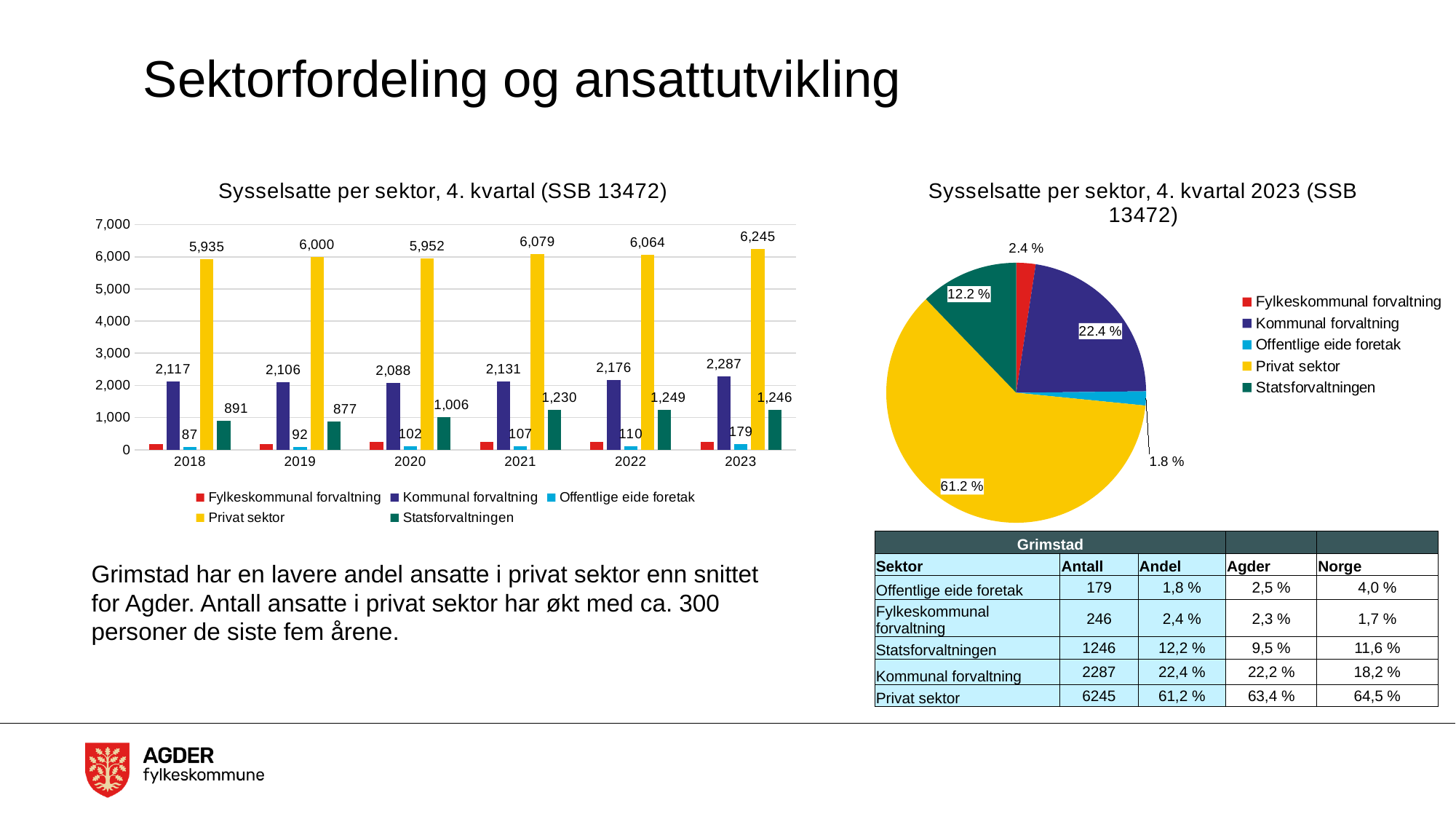
In the pie chart 'Sysselsatte per sektor, 4. kvartal 2023 (SSB 13472)', what share does Privat sektor have? 61.2 % In the bar chart 'Sysselsatte per sektor, 4. kvartal (SSB 13472)', how many years are shown on the x axis? 6 In the bar chart 'Sysselsatte per sektor, 4. kvartal (SSB 13472)', in which year is the Kommunal forvaltning value lowest? 2020 In the bar chart 'Sysselsatte per sektor, 4. kvartal (SSB 13472)', what is the difference between the Privat sektor values for 2023 and 2018? 310 In the pie chart 'Sysselsatte per sektor, 4. kvartal 2023 (SSB 13472)', which colour represents Statsforvaltningen? Dark green In the bar chart 'Sysselsatte per sektor, 4. kvartal (SSB 13472)', what is the value for Statsforvaltningen in 2021? 1,230 In the bar chart 'Sysselsatte per sektor, 4. kvartal (SSB 13472)', what is the value for Privat sektor in 2023? 6,245 In the bar chart 'Sysselsatte per sektor, 4. kvartal (SSB 13472)', what is the value for Offentlige eide foretak in 2019? 92 What kind of chart is 'Sysselsatte per sektor, 4. kvartal (SSB 13472)' on the left of the slide? Bar chart In the bar chart 'Sysselsatte per sektor, 4. kvartal (SSB 13472)', how many series does the legend list? 5 In the bar chart 'Sysselsatte per sektor, 4. kvartal (SSB 13472)', in which year is the Privat sektor value highest? 2023 In the bar chart 'Sysselsatte per sektor, 4. kvartal (SSB 13472)', which is larger: Statsforvaltningen in 2022 or Statsforvaltningen in 2023? 2022